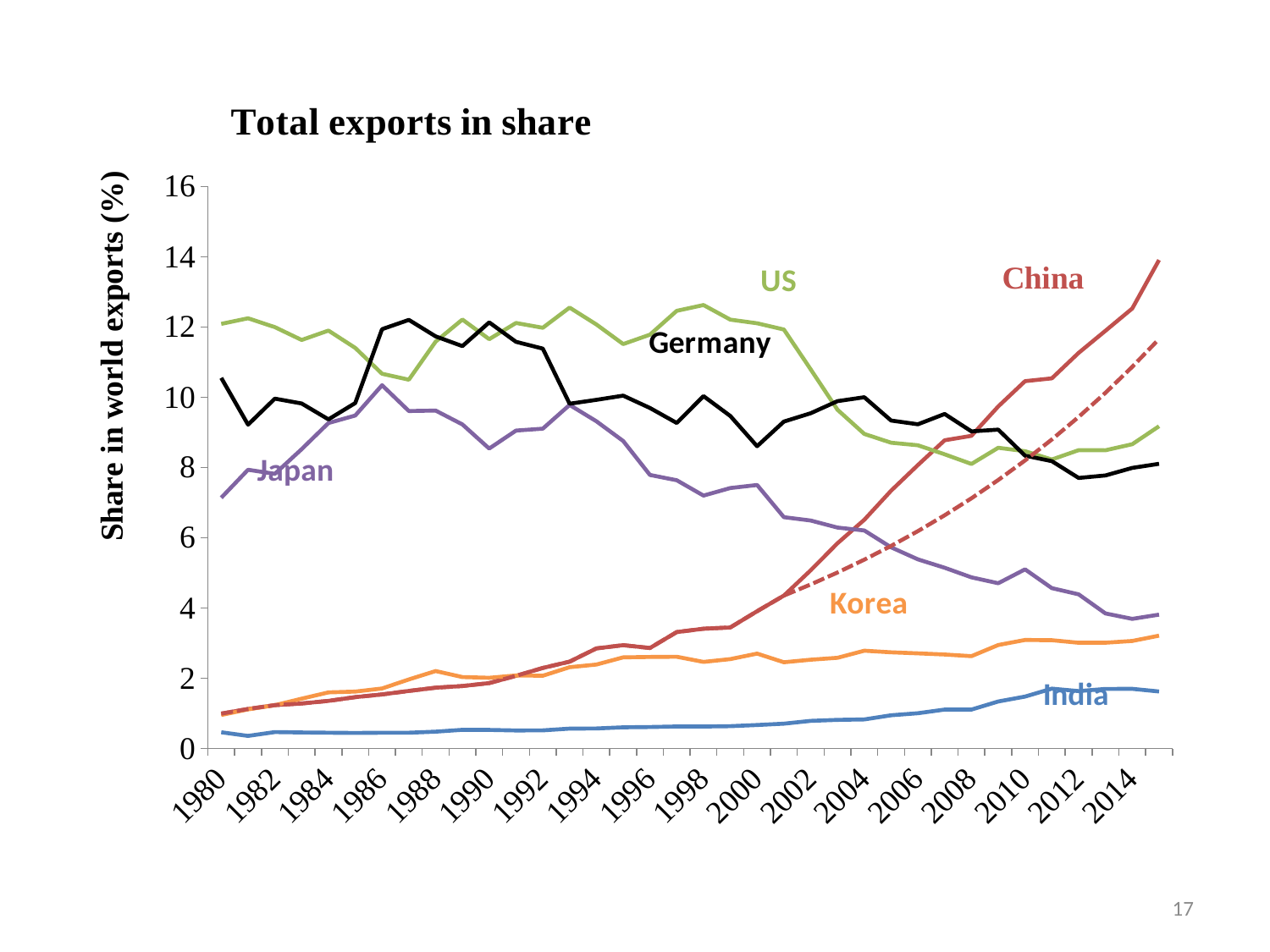
Does Japan's share in world exports rise or fall from 1980 to the end of the series? fall Is Japan's share in world exports in 2010 greater or less than 6? less In 1980, which has the larger share in world exports, the US or Germany? US Which country has the lowest share in world exports across the whole period? India Does China's share in world exports rise or fall from 1980 to the end of the series? rise How many countries are labelled on the chart? 6 What is the label of the vertical axis? Share in world exports (%) Is China's share in world exports in 1980 greater or less than 2? less In 2014, which has the larger share in world exports, Korea or India? Korea Which country has the highest share in world exports at the end of the series? China What kind of chart is shown on the slide? line chart What is the title of the chart? Total exports in share